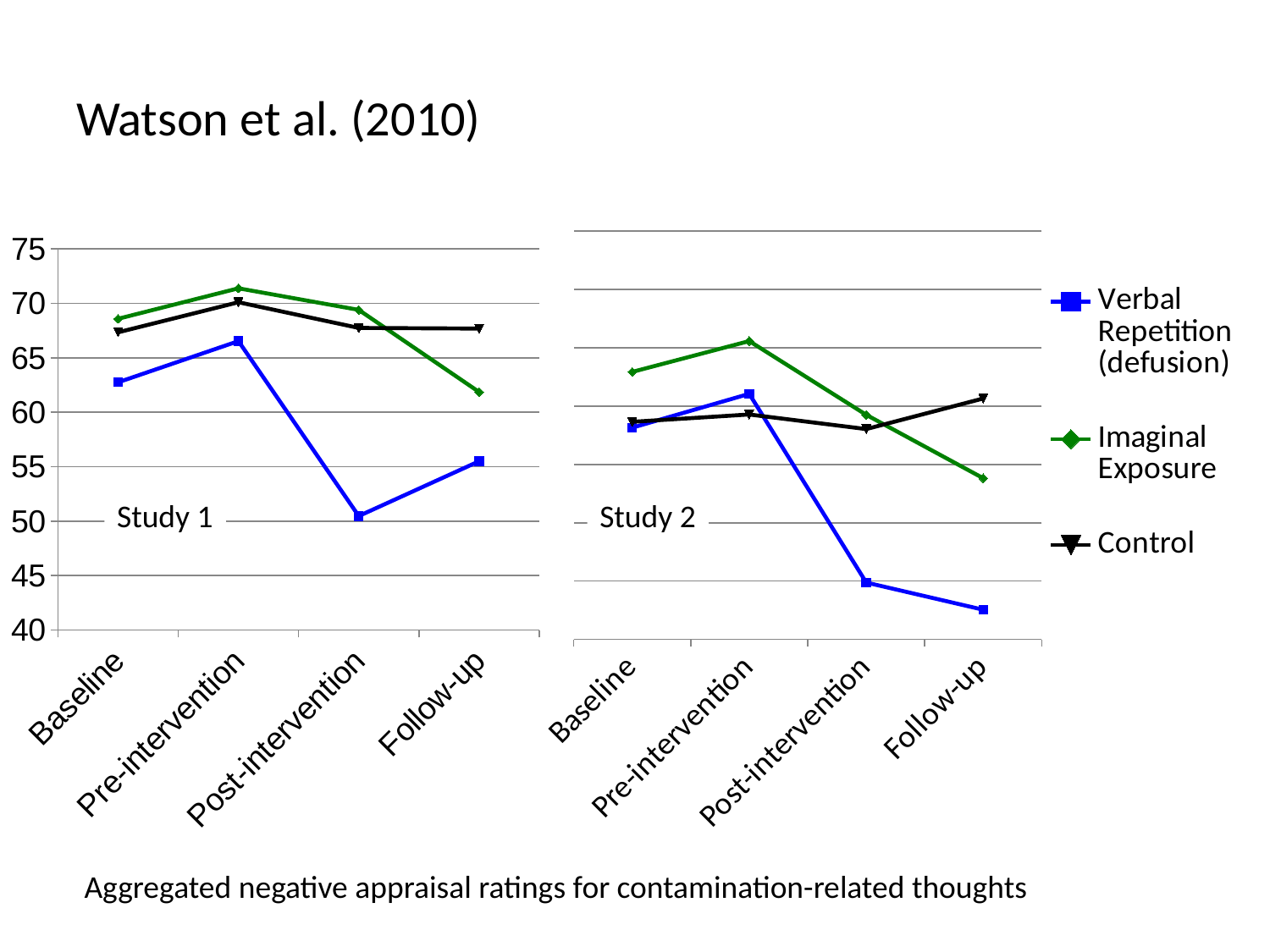
What colour is the Imaginal Exposure line in the legend? Green In the Study 1 chart, is the Verbal Repetition (defusion) value at Post-intervention greater or less than 55? less How many series does the legend list? 3 In the Study 1 chart, is the Imaginal Exposure value at Pre-intervention greater or less than 70? greater In the Study 2 chart, is the Verbal Repetition (defusion) value at Follow-up greater or less than 45? less In the Study 1 chart, which series has the highest value at Follow-up? Control In the Study 2 chart, which series has the lowest value at Post-intervention? Verbal Repetition (defusion) In the Study 1 chart, at Baseline, which is larger: Imaginal Exposure or Verbal Repetition (defusion)? Imaginal Exposure In the Study 2 chart, at Follow-up, which is larger: Control or Imaginal Exposure? Control In the Study 2 chart, how many time points are shown on the x axis? 4 What kind of chart is used for Study 1? Line chart In the Study 2 chart, does the Verbal Repetition (defusion) line rise or fall from Pre-intervention to Follow-up? Fall